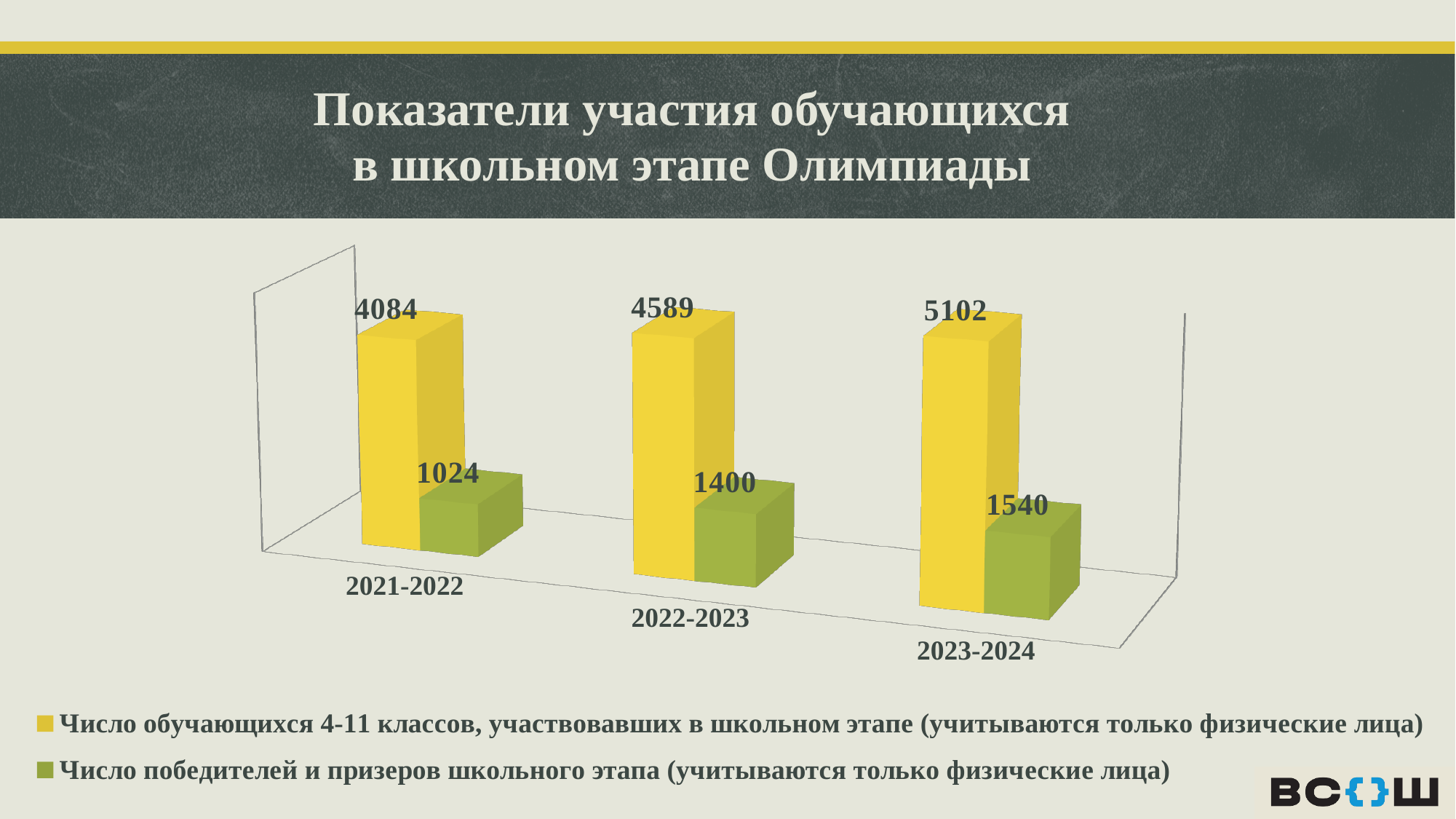
How many academic years are shown on the chart? 3 What is the number of winners and prize-winners of the school stage in 2022-2023? 1400 What is the difference between the number of winners and prize-winners in 2023-2024 and in 2022-2023? 140 In which academic year was the number of winners and prize-winners lowest? 2021-2022 What is the number of participants in the school stage in 2023-2024? 5102 Do the numbers of winners and prize-winners rise or fall from 2021-2022 to 2023-2024? Rise What is the difference between the number of participants in 2023-2024 and in 2021-2022? 1018 What kind of chart is shown on the slide? Bar chart How many series does the legend list? 2 Which is larger: the number of participants in 2022-2023 or in 2021-2022? 2022-2023 In which academic year was the number of participants in the school stage highest? 2023-2024 How many students in grades 4-11 participated in the school stage in 2021-2022? 4084